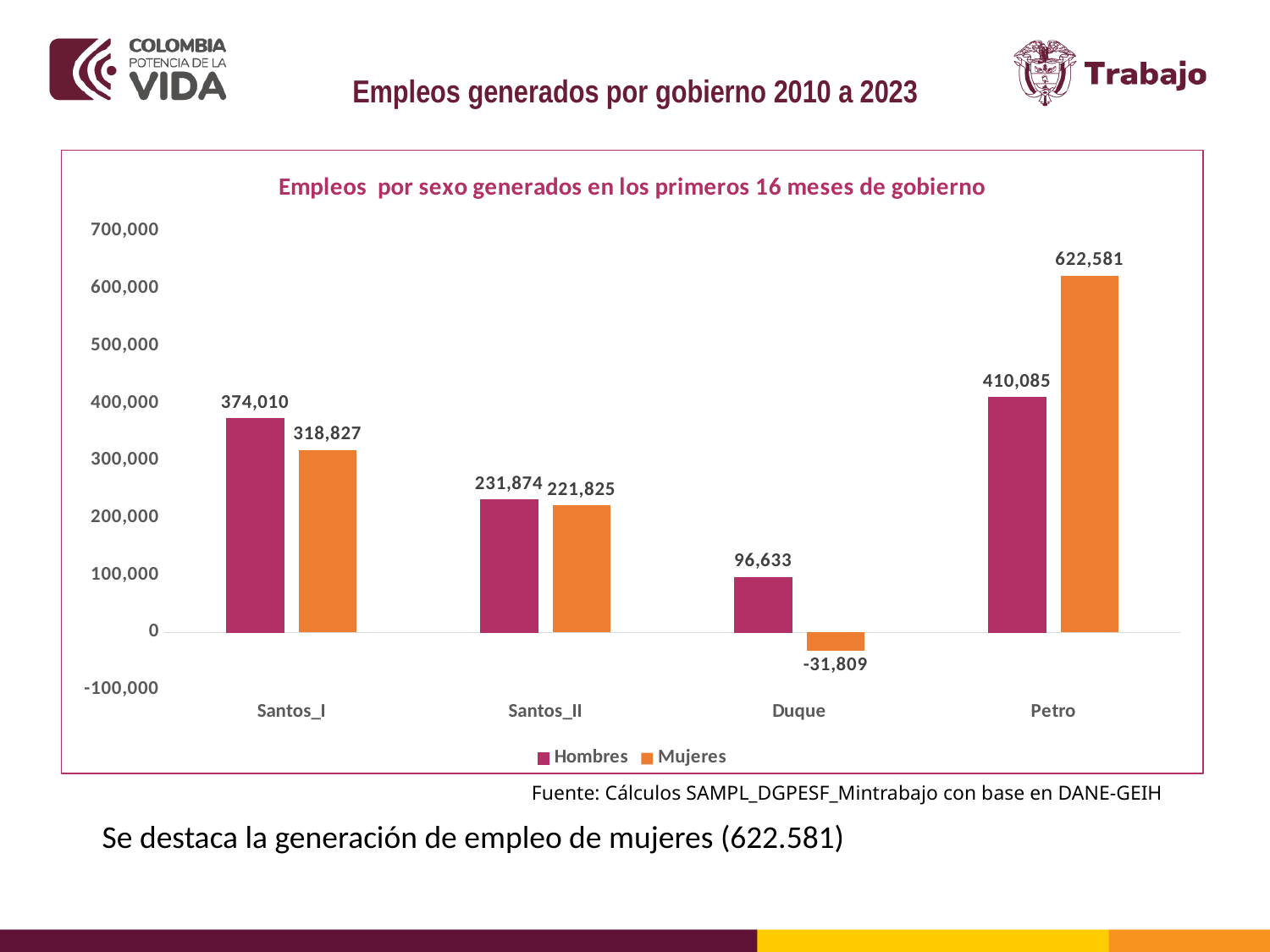
What is the value for Mujeres under Petro? 622,581 Is the value for Hombres under Duque greater or less than 100,000? less What is the title of the chart? Empleos por sexo generados en los primeros 16 meses de gobierno How many series does the legend list? 2 What is the value for Mujeres under Duque? -31,809 Which government has the highest value for Hombres? Petro What is the difference between Hombres and Mujeres under Santos_II? 10,049 Which government has the lowest value for Mujeres? Duque What kind of chart is shown? bar chart What is the value for Hombres under Santos_I? 374,010 Under Petro, which is larger, Hombres or Mujeres? Mujeres How many governments are shown on the x axis? 4